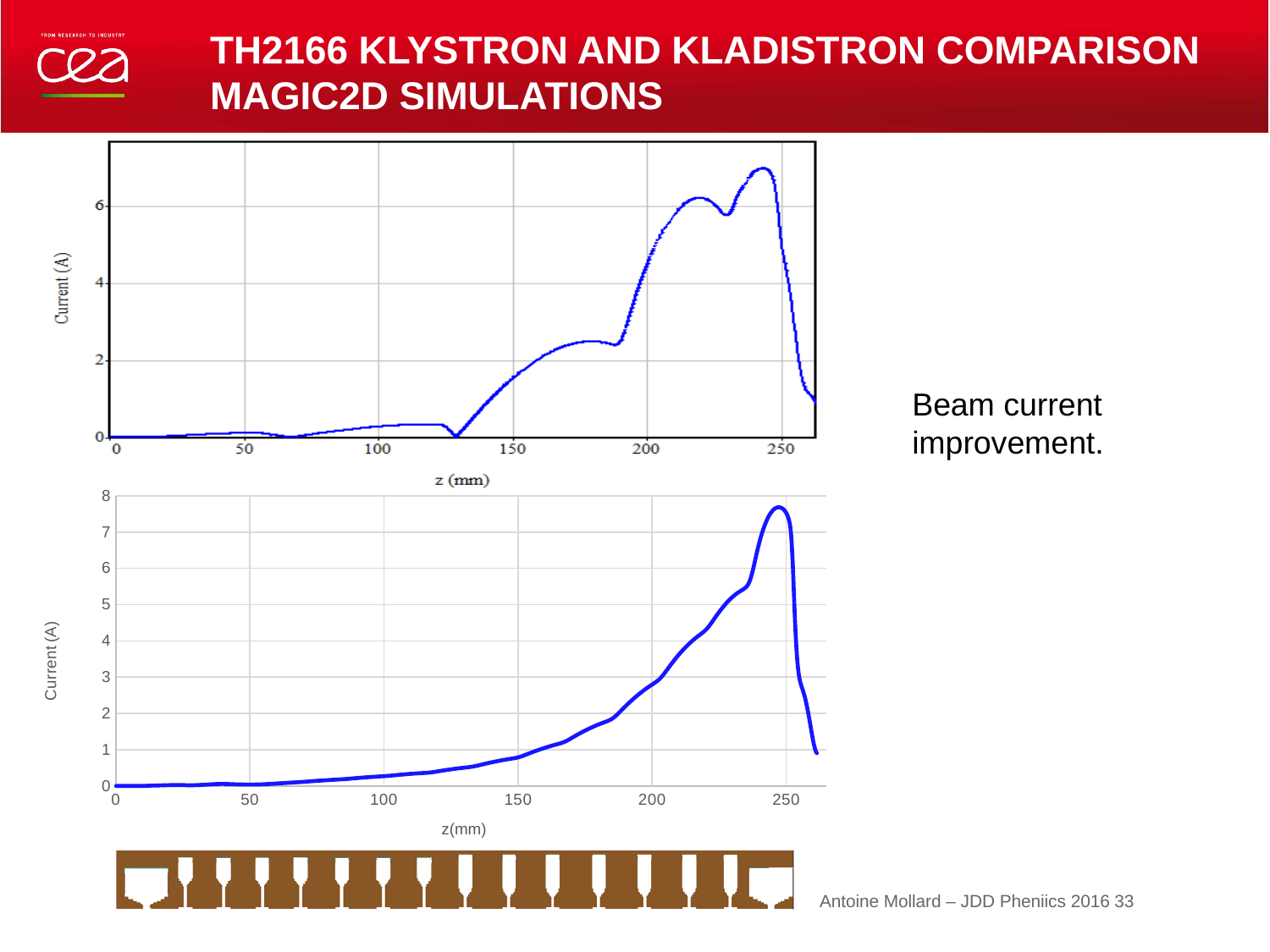
In the bottom chart, is the current at z = 200 mm greater or less than 4? less In the bottom chart, is the peak current value greater or less than 7? greater In the top chart, is the current at z = 200 mm greater or less than 4? greater What is the label of the y axis on the bottom chart? Current (A) What kind of chart is the bottom chart on the slide? line chart In the top chart, does the current rise or fall between z = 250 mm and the end of the curve? fall What kind of chart is the top chart on the slide? line chart In the bottom chart, does the current rise or fall between z = 100 mm and z = 200 mm? rise What is the label of the x axis on the top chart? z (mm)